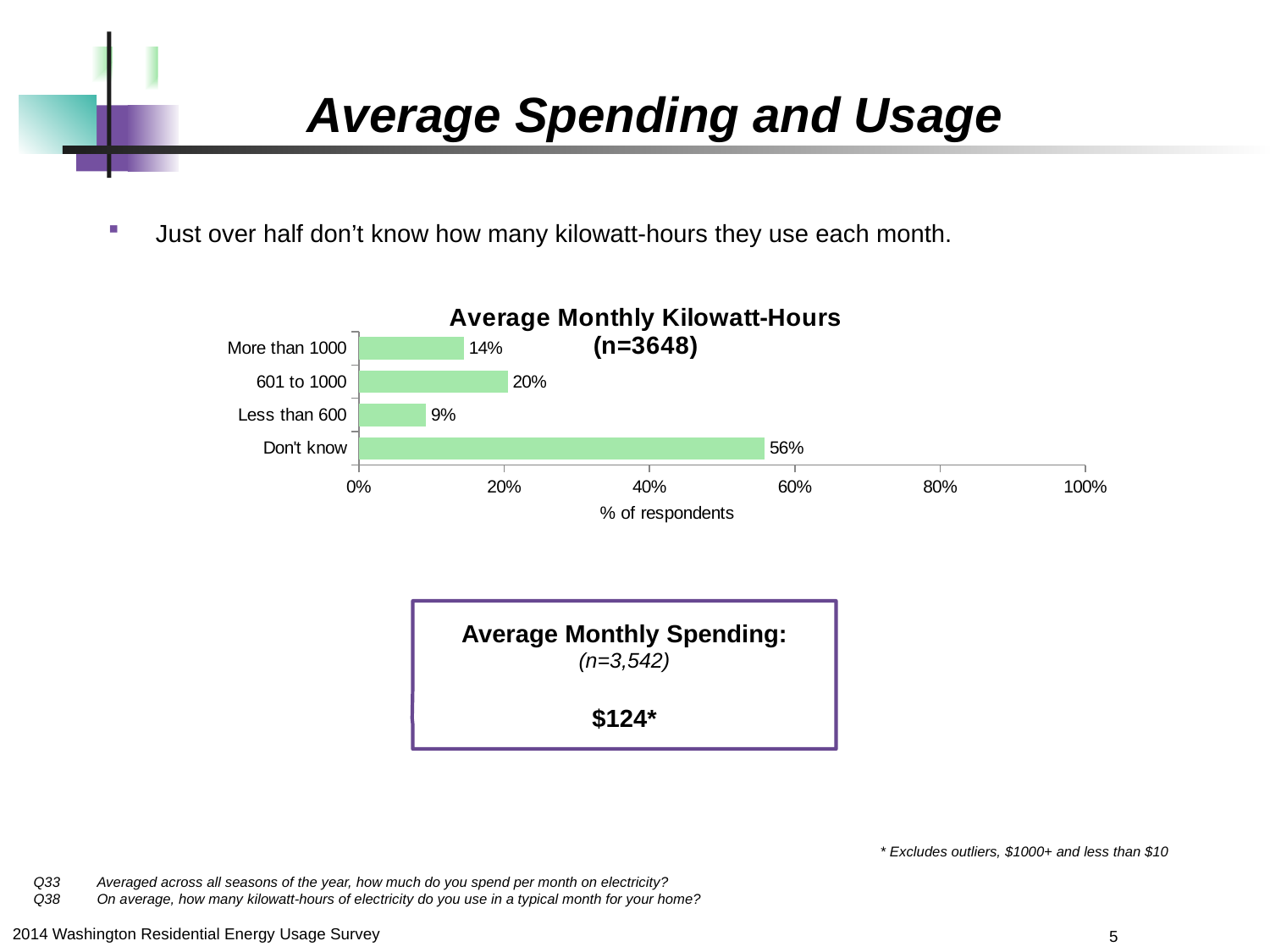
What percentage of respondents use 601 to 1000 kilowatt-hours per month? 20% What percentage of respondents answered "Don't know" for average monthly kilowatt-hours? 56% Is the value for "Don't know" greater or less than 40%? greater What is the difference in percentage points between "Don't know" and "601 to 1000"? 36 What percentage of respondents use more than 1000 kilowatt-hours per month? 14% Which category has the lowest percentage of respondents? Less than 600 What is the sample size (n) shown in the chart title? 3648 What type of chart is used to show average monthly kilowatt-hours? Bar chart How many categories are shown in the chart? 4 Which is larger: the percentage for "More than 1000" or for "601 to 1000"? 601 to 1000 What percentage of respondents use less than 600 kilowatt-hours per month? 9% Which category has the highest percentage of respondents? Don't know